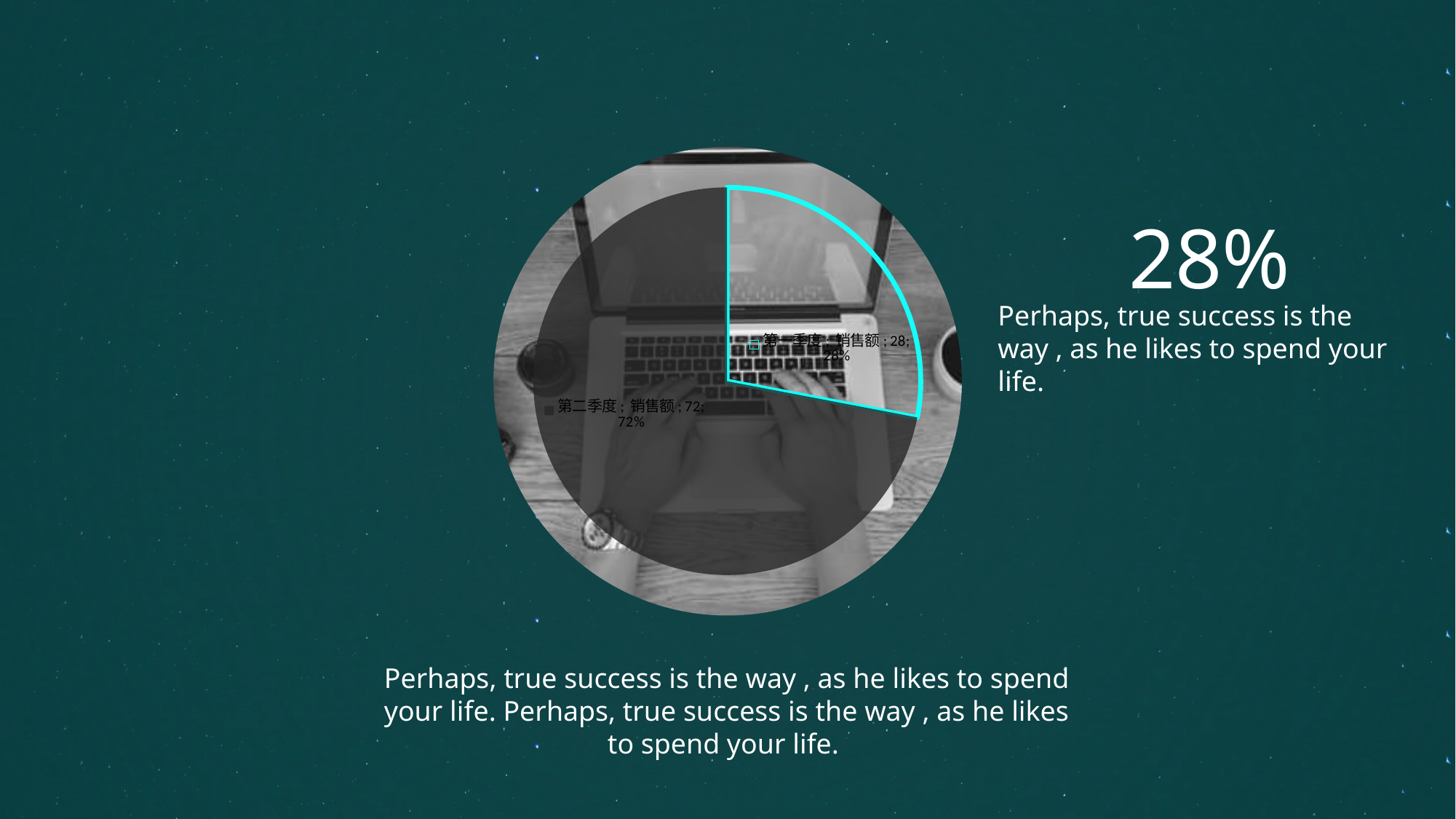
What is the difference between the values for 第二季度 and 第一季度? 44 What share of the pie does 第一季度 represent? 28% How many slices does the pie chart have? 2 Which is larger, the value for 第一季度 or 第二季度? 第二季度 What series name appears in the data labels of the pie chart? 销售额 What share of the pie does 第二季度 represent? 72% What is the value for 第一季度 in the pie chart? 28 Which slice of the pie chart is the smallest? 第一季度 What is the value for 第二季度 in the pie chart? 72 Which slice of the pie chart is the largest? 第二季度 What kind of chart is shown on the slide? pie chart What is the total of the two slice values in the pie chart? 100